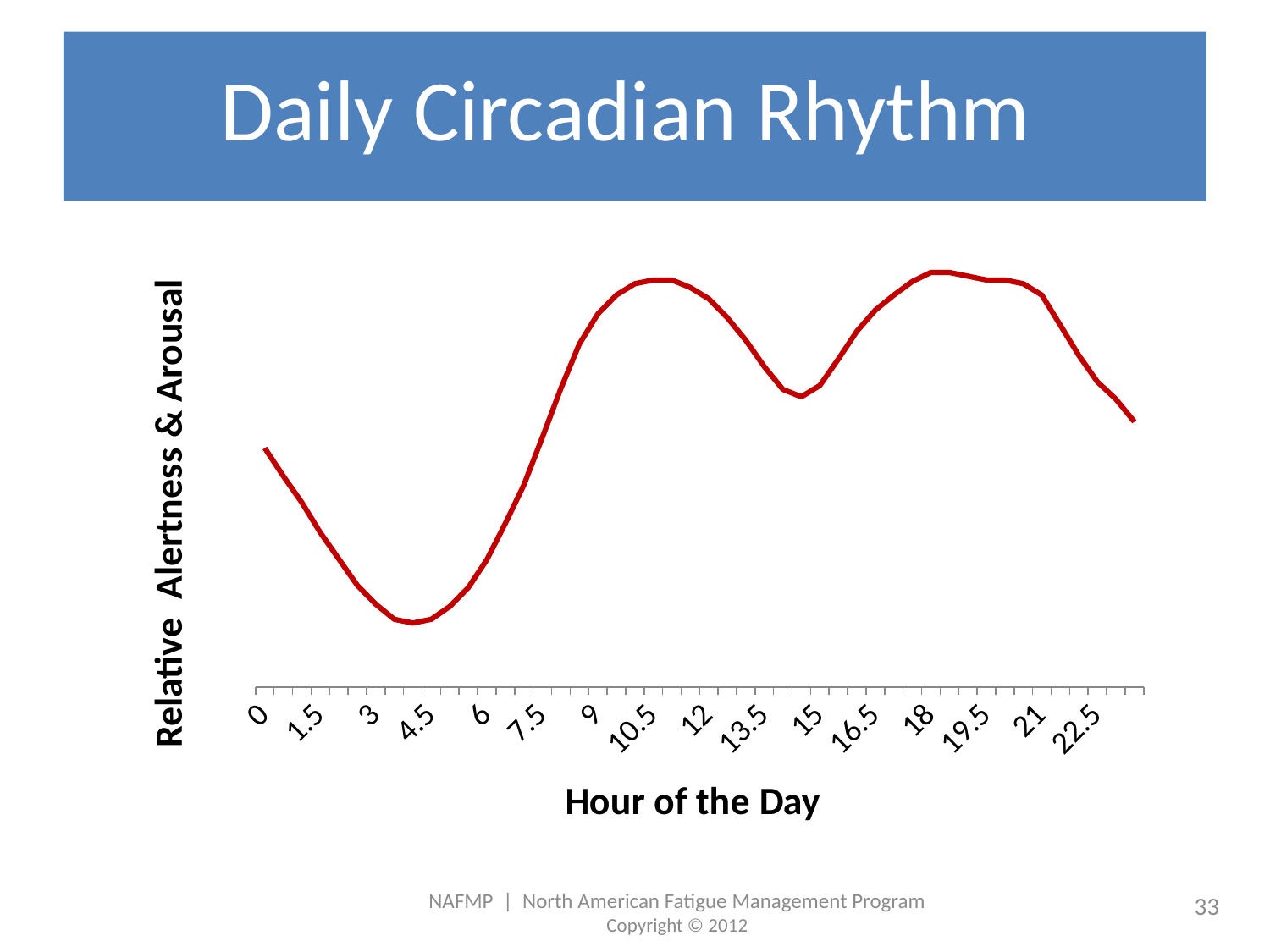
Does the line rise or fall between hour 12 and hour 15? Fall What is the title of the chart? Daily Circadian Rhythm What is the label of the x axis? Hour of the Day Which is higher, the value at hour 9 or the value at hour 3? Hour 9 Does the line rise or fall between hour 4.5 and hour 10.5? Rise What kind of chart is shown on the slide? Line chart Which is higher, the value at hour 15 or the value at hour 4.5? Hour 15 How many hour labels are shown on the x axis? 16 Does the line rise or fall between hour 0 and hour 4.5? Fall Which is higher, the value at hour 12 or the value at hour 15? Hour 12